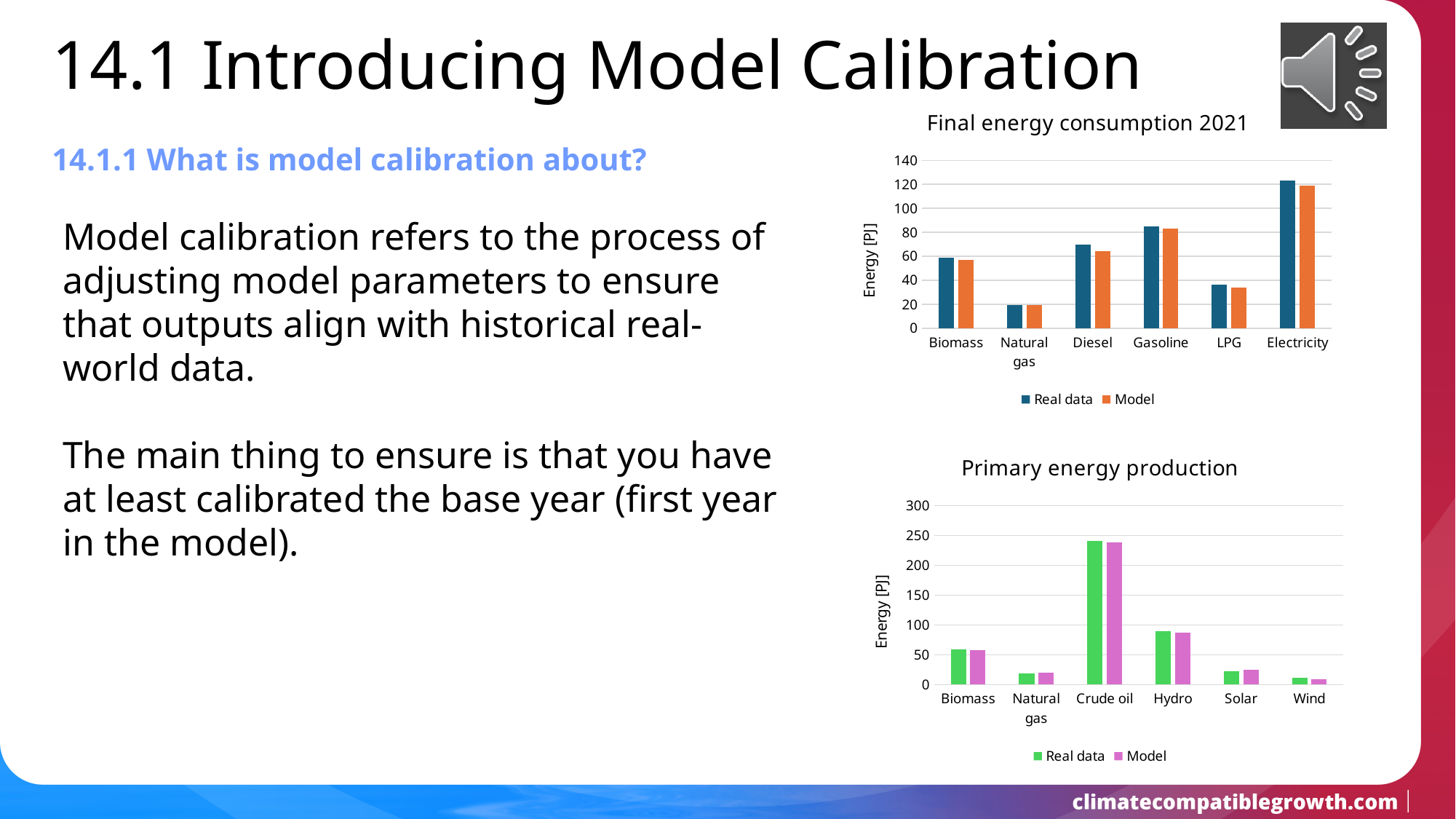
What kind of chart is the 'Final energy consumption 2021' chart? bar chart In the 'Final energy consumption 2021' chart, is the Model value for LPG greater or less than 40? less In the 'Primary energy production' chart, is the Real data value for Crude oil greater or less than 200? greater In the 'Primary energy production' chart, which category has the lowest Real data value? Wind In the 'Final energy consumption 2021' chart, which category has the lowest Real data value? Natural gas In the 'Final energy consumption 2021' chart, which has the larger Real data value, Diesel or Gasoline? Gasoline In the 'Final energy consumption 2021' chart, how many categories are shown on the x axis? 6 In the 'Primary energy production' chart, which category has the highest Real data value? Crude oil In the 'Final energy consumption 2021' chart, how many series does the legend list? 2 In the 'Final energy consumption 2021' chart, which category has the highest Real data value? Electricity In the 'Final energy consumption 2021' chart, is the Real data value for Electricity greater or less than 100? greater In the 'Primary energy production' chart, which has the larger Model value, Hydro or Biomass? Hydro